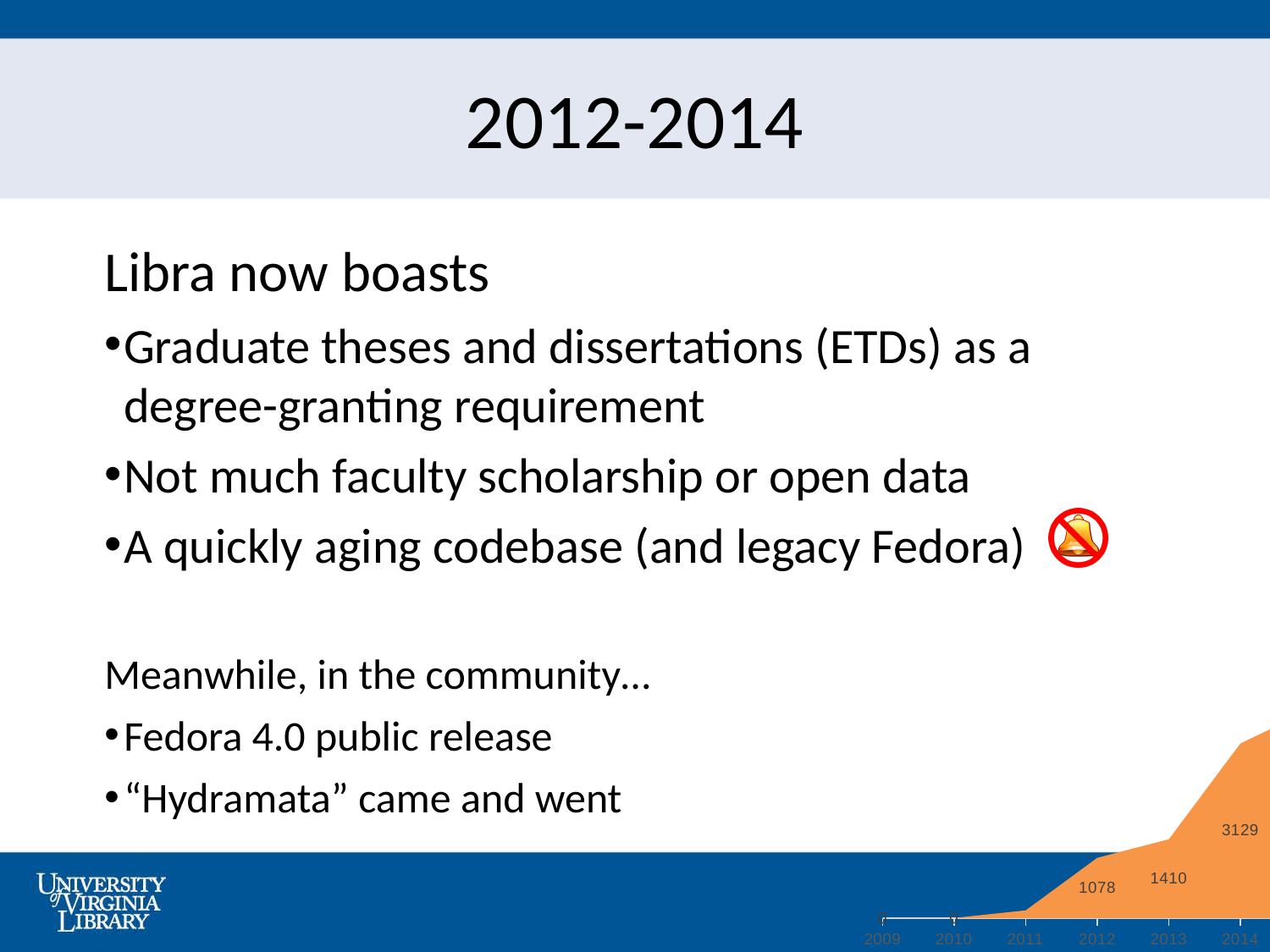
In the chart at the bottom right, what is the difference between the 2013 value and the 2012 value? 332 How many years are labelled on the x axis of the chart at the bottom right? 6 What colour is the filled area in the chart at the bottom right? orange In the chart at the bottom right, which is larger, the value for 2013 or the value for 2014? 2014 What kind of chart is shown in the bottom right corner of the slide? area chart In the chart at the bottom right, which year has the highest value? 2014 In the chart at the bottom right, what is the value labelled for 2014? 3129 In the chart at the bottom right, do the values rise or fall from 2012 to 2014? rise In the chart at the bottom right, what is the value labelled for 2013? 1410 In the chart at the bottom right, what is the difference between the 2014 value and the 2012 value? 2051 In the chart at the bottom right, what is the difference between the 2014 value and the 2013 value? 1719 In the chart at the bottom right, what is the value labelled for 2012? 1078